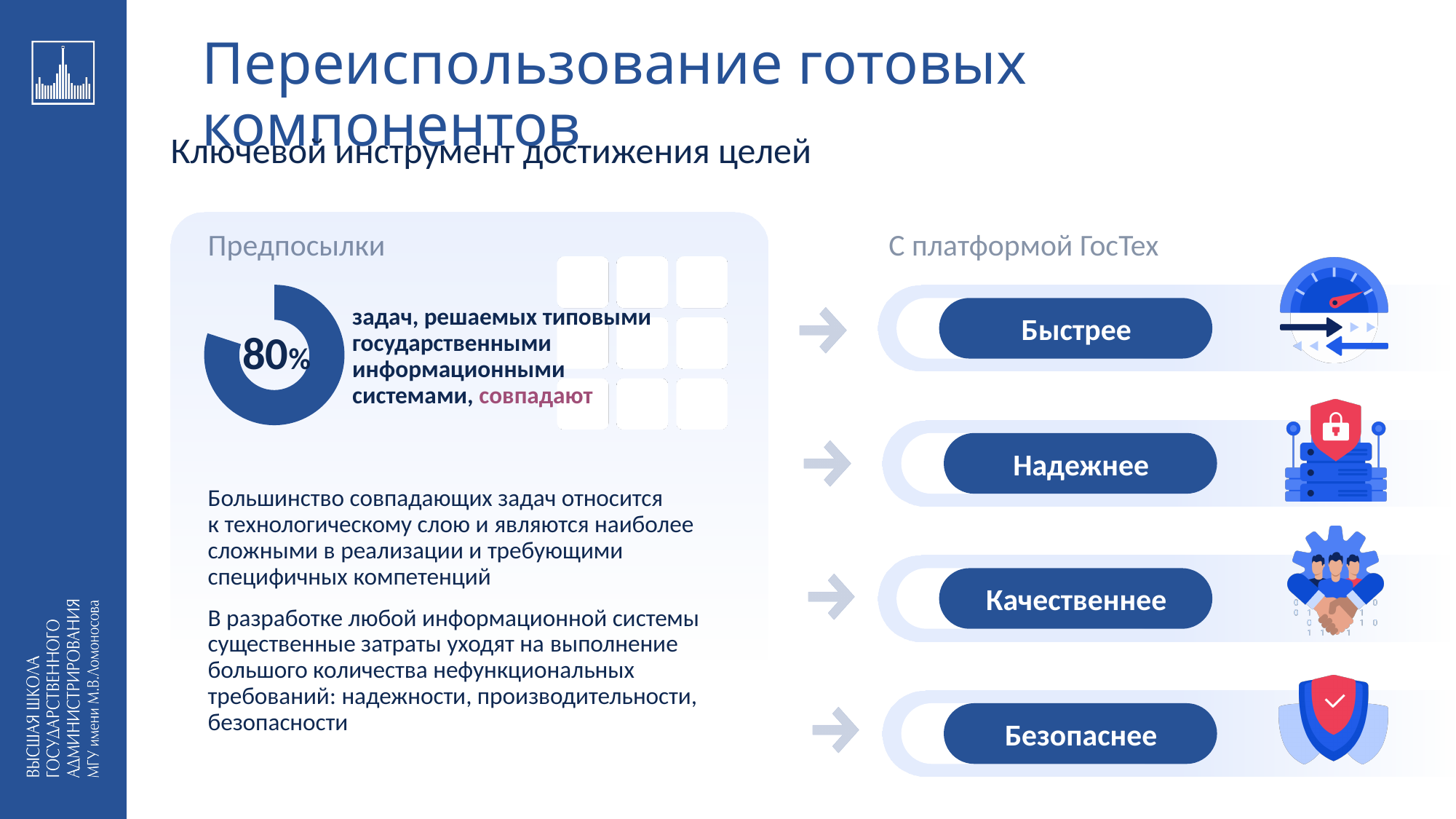
What share of the doughnut chart is filled in dark blue? 80% According to the text next to the doughnut chart, what does the 80% refer to? задач, решаемых типовыми государственными информационными системами, совпадают What kind of chart is used to illustrate the 80% figure under "Предпосылки"? doughnut chart Under which heading is the doughnut chart placed? Предпосылки What percentage is shown in the centre of the doughnut chart on the left of the slide? 80% Is the value shown in the doughnut chart greater or less than 50%? greater Is the filled portion of the doughnut chart larger or smaller than the unfilled portion? larger What share of the doughnut chart is left unfilled? 20%